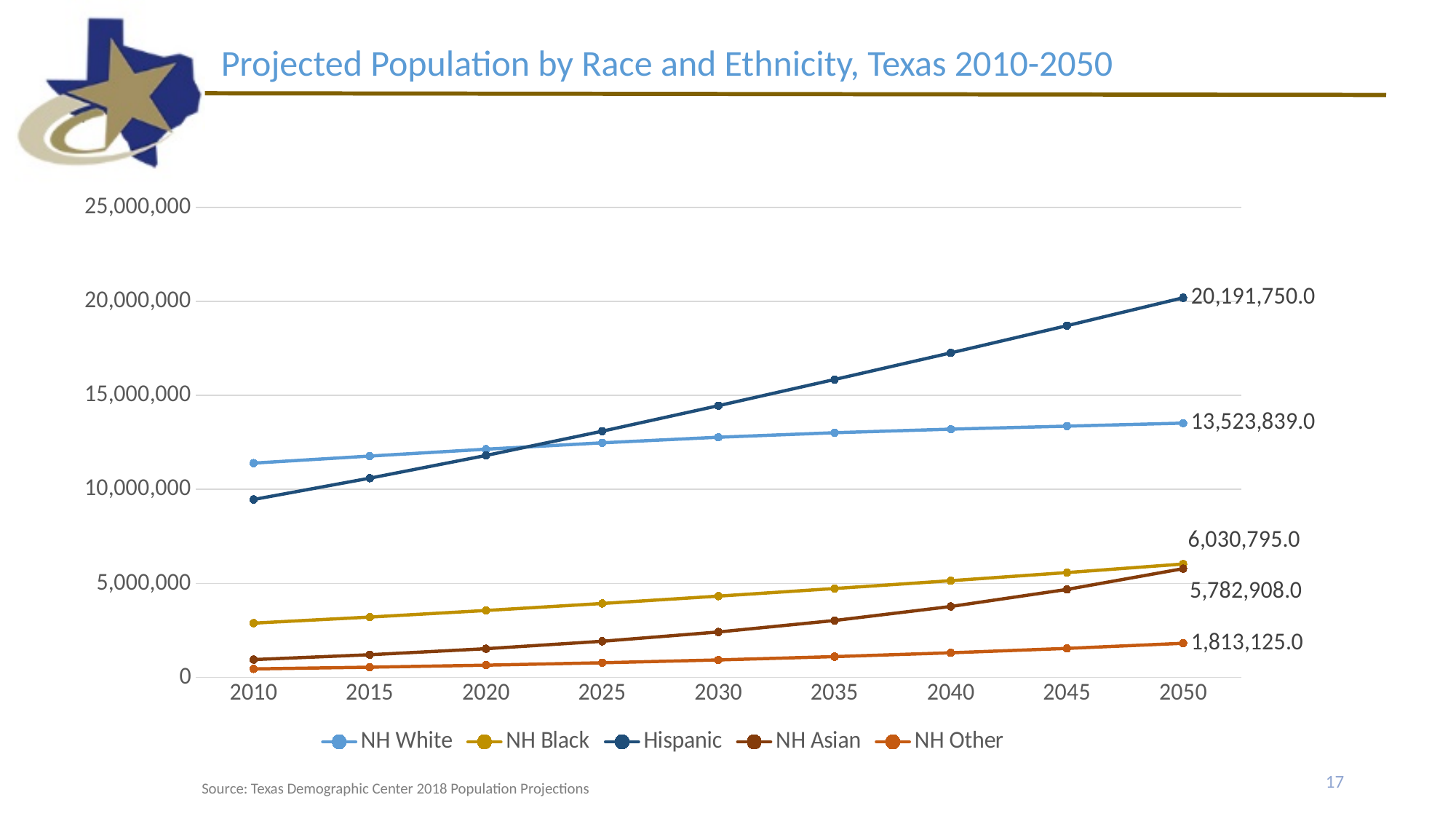
What is the projected Hispanic population in 2050? 20,191,750.0 What is the projected NH White population in 2050? 13,523,839.0 What is the projected NH Other population in 2050? 1,813,125.0 Does the Hispanic line rise or fall from 2010 to 2050? rise What is the projected NH Asian population in 2050? 5,782,908.0 Which group has the highest projected population in 2050? Hispanic What is the difference between the Hispanic and NH White projected populations in 2050? 6,667,911.0 How many series does the legend list? 5 Which group has the lowest projected population in 2050? NH Other In 2050, which is larger: the NH Black or the NH Asian projected population? NH Black Is the Hispanic population value for 2010 greater or less than 10,000,000? less What kind of chart is shown on the slide? line chart